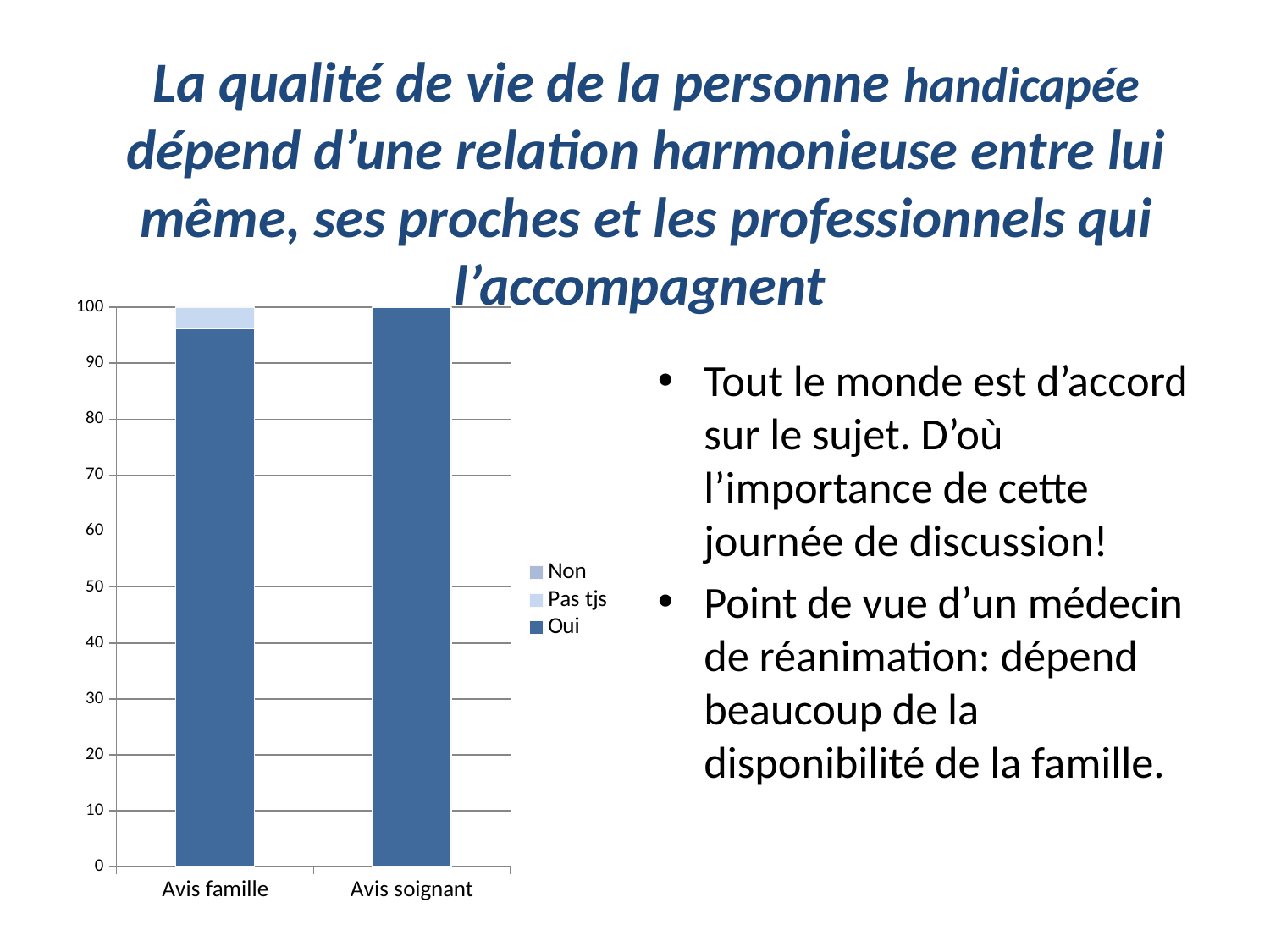
How many categories are shown on the x axis of the chart? 2 What kind of chart is shown on the slide? bar chart How many series does the chart legend list? 3 What are the series listed in the chart legend? Non, Pas tjs, Oui What is the value of Oui for Avis soignant? 100 Is the value of Pas tjs for Avis famille greater or less than 10? less Which category has the lower value for Oui? Avis famille Is the value of Oui for Avis famille greater or less than 90? greater Which category has the higher value for Oui, Avis famille or Avis soignant? Avis soignant Which category shows a visible Pas tjs segment in its bar? Avis famille What are the two categories on the x axis of the chart? Avis famille, Avis soignant